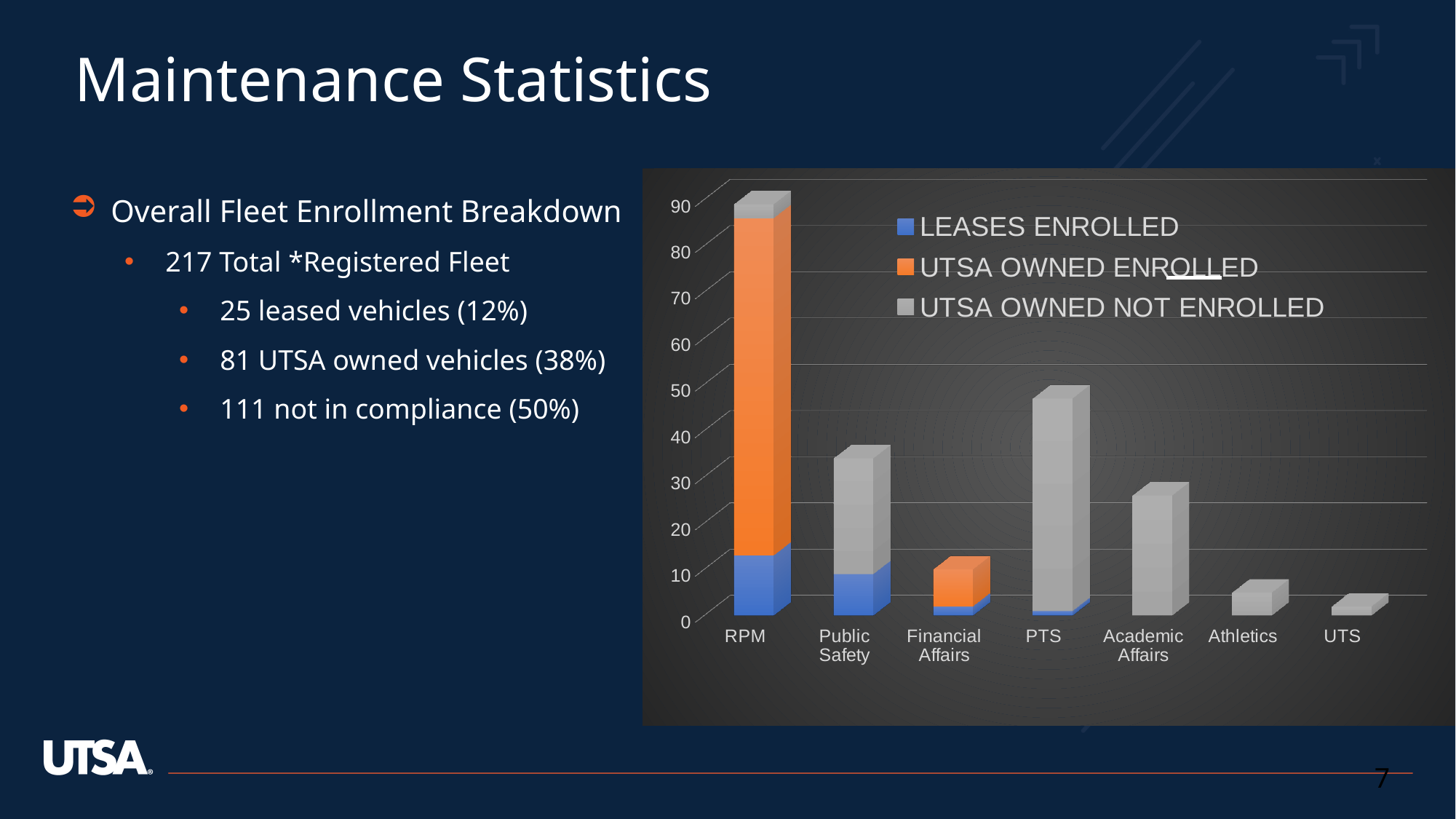
Which category has the shortest stacked bar in the chart? UTS How many series does the chart legend list? 3 Which colour represents the UTSA OWNED ENROLLED series in the chart? Orange Is the total stacked bar for Athletics greater or less than 10? less Which category has the tallest stacked bar in the chart? RPM How many categories are shown along the x axis of the chart? 7 Is the total stacked bar for Public Safety greater or less than 40? less What kind of chart is shown on the slide? Bar chart Which stacked bar is taller, PTS or Public Safety? PTS Is the total stacked bar for PTS greater or less than 40? greater Which stacked bar is taller, Academic Affairs or Athletics? Academic Affairs